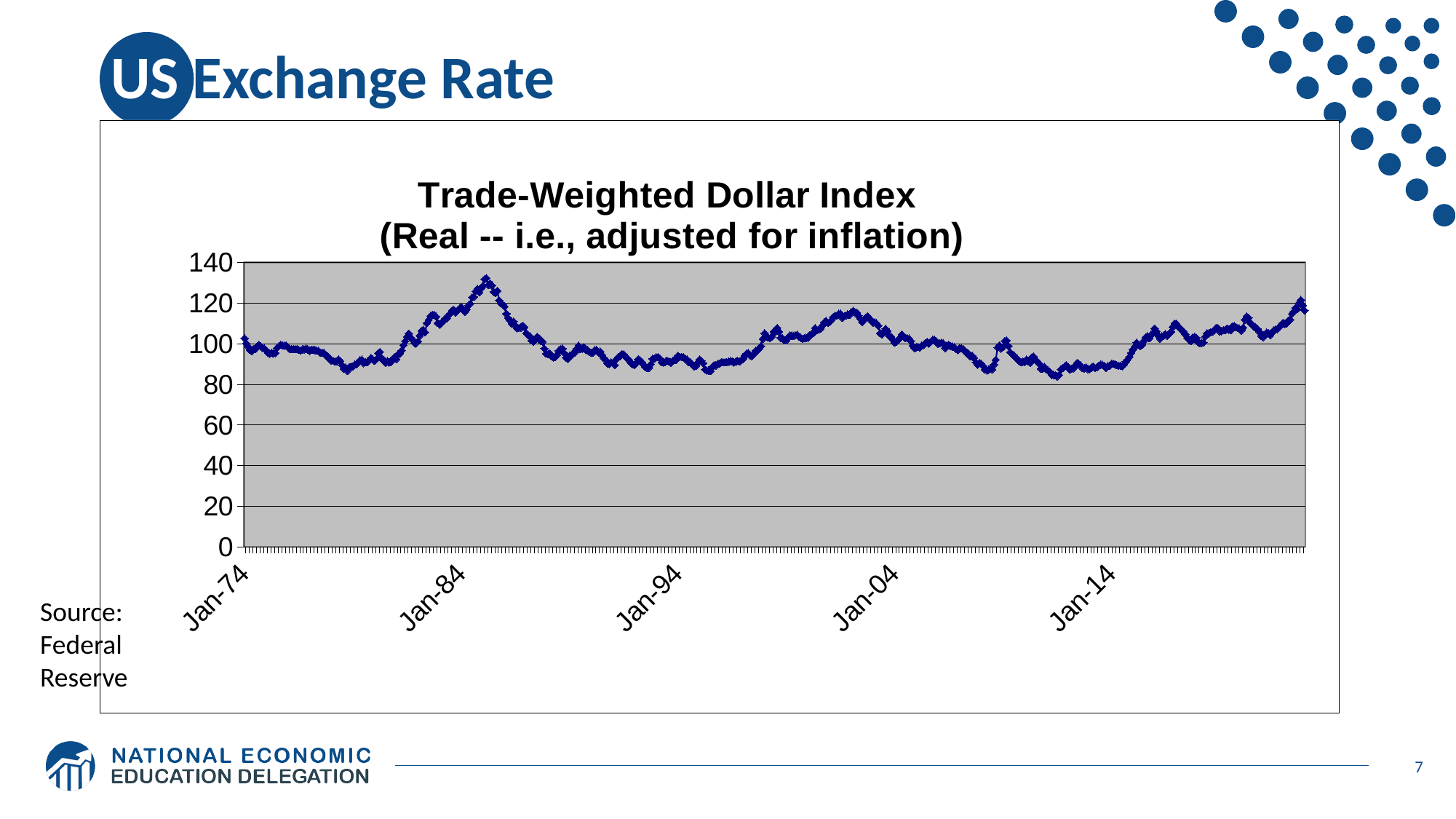
Is the value of the index at Jan-14 greater or less than 100? less Is the lowest value of the index, reached around 2011, greater or less than 80? greater How many data series are plotted in the chart? 1 Does the index rise or fall overall between Jan-84 and Jan-94? fall Is the value of the index at Jan-94 greater or less than 100? less What kind of chart is shown on the slide? line chart Which labeled x-axis date is the highest point of the index closest to: Jan-74, Jan-84, Jan-94, Jan-04 or Jan-14? Jan-84 What is the title of the chart? Trade-Weighted Dollar Index (Real -- i.e., adjusted for inflation) What is the highest value shown on the y-axis? 140 Does the index rise or fall overall from Jan-14 to the end of the series? rise